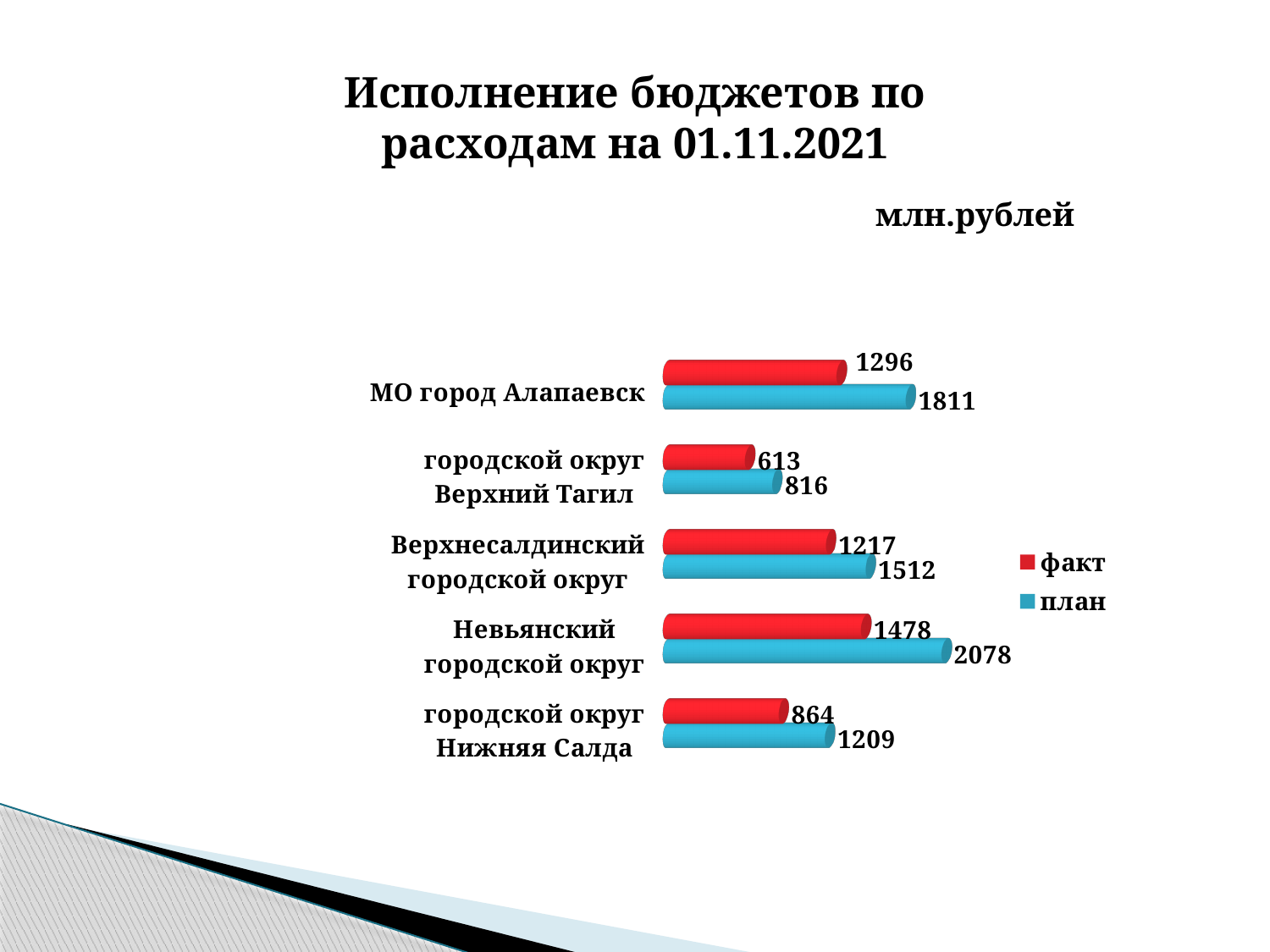
How many categories are shown in the chart? 5 What is the факт value for МО город Алапаевск? 1296 Which colour represents the план series? blue Which category has the lowest факт value? городской округ Верхний Тагил Which is larger: the факт value for МО город Алапаевск or the факт value for Верхнесалдинский городской округ? МО город Алапаевск What is the difference between the план and факт values for Верхнесалдинский городской округ? 295 What is the план value for городской округ Верхний Тагил? 816 How many series does the legend list? 2 What is the план value for Невьянский городской округ? 2078 What is the факт value for городской округ Нижняя Салда? 864 Which category has the highest план value? Невьянский городской округ What kind of chart is shown on the slide? bar chart